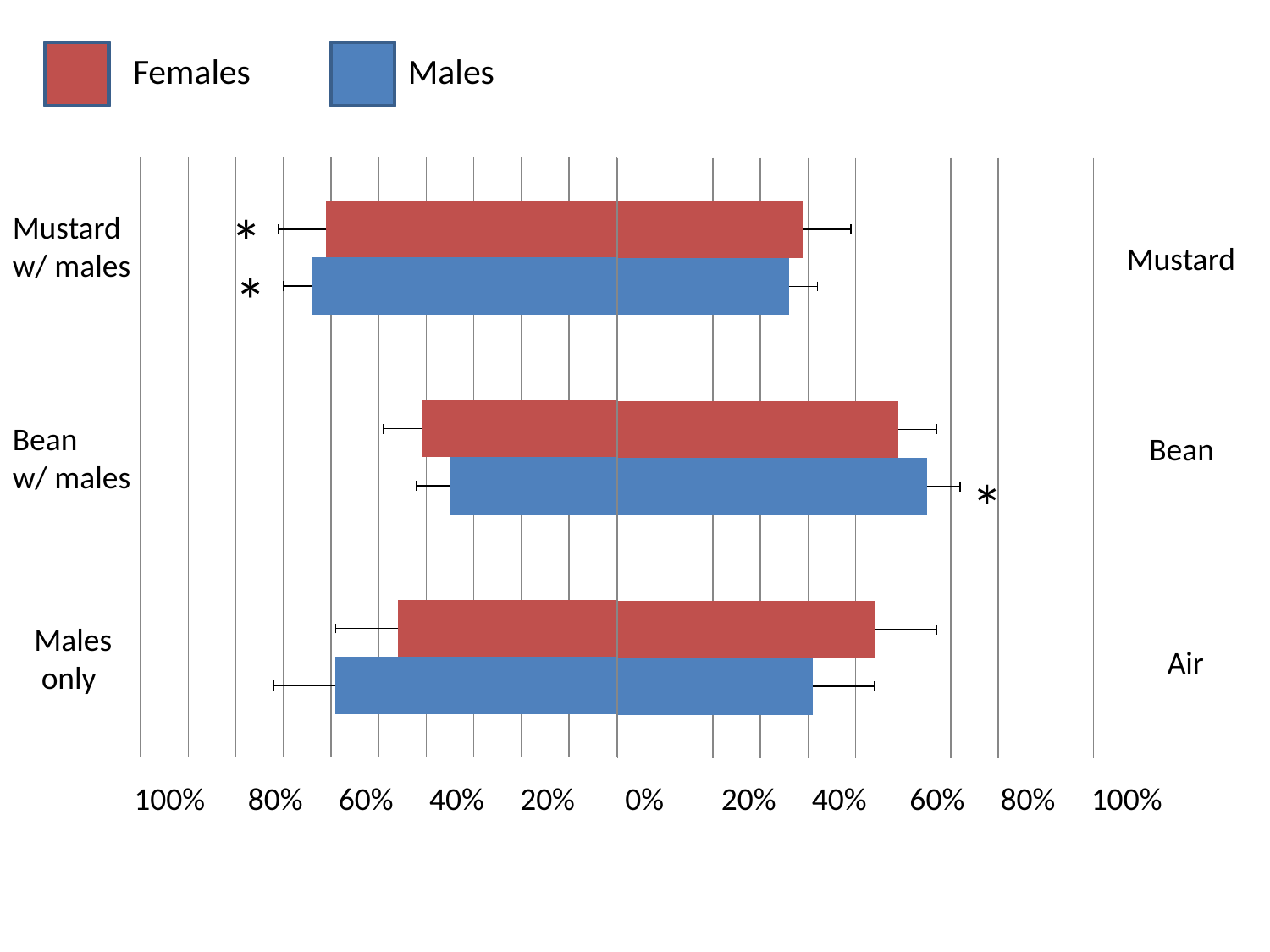
What kind of chart is shown on the slide? bar chart Is the Females value for Air greater or less than 40%? greater How many category labels appear on the left side of the chart? 3 Is the Males value for Air greater or less than 60%? less Is the Males value for Bean (right side) greater or less than 60%? greater How many series does the legend list? 2 For Air, which series has the longer bar, Females or Males? Females For Males only, which series has the longer bar, Females or Males? Males Which colour represents Females in the chart? red Which category on the right side of the chart has the longest Males bar? Bean